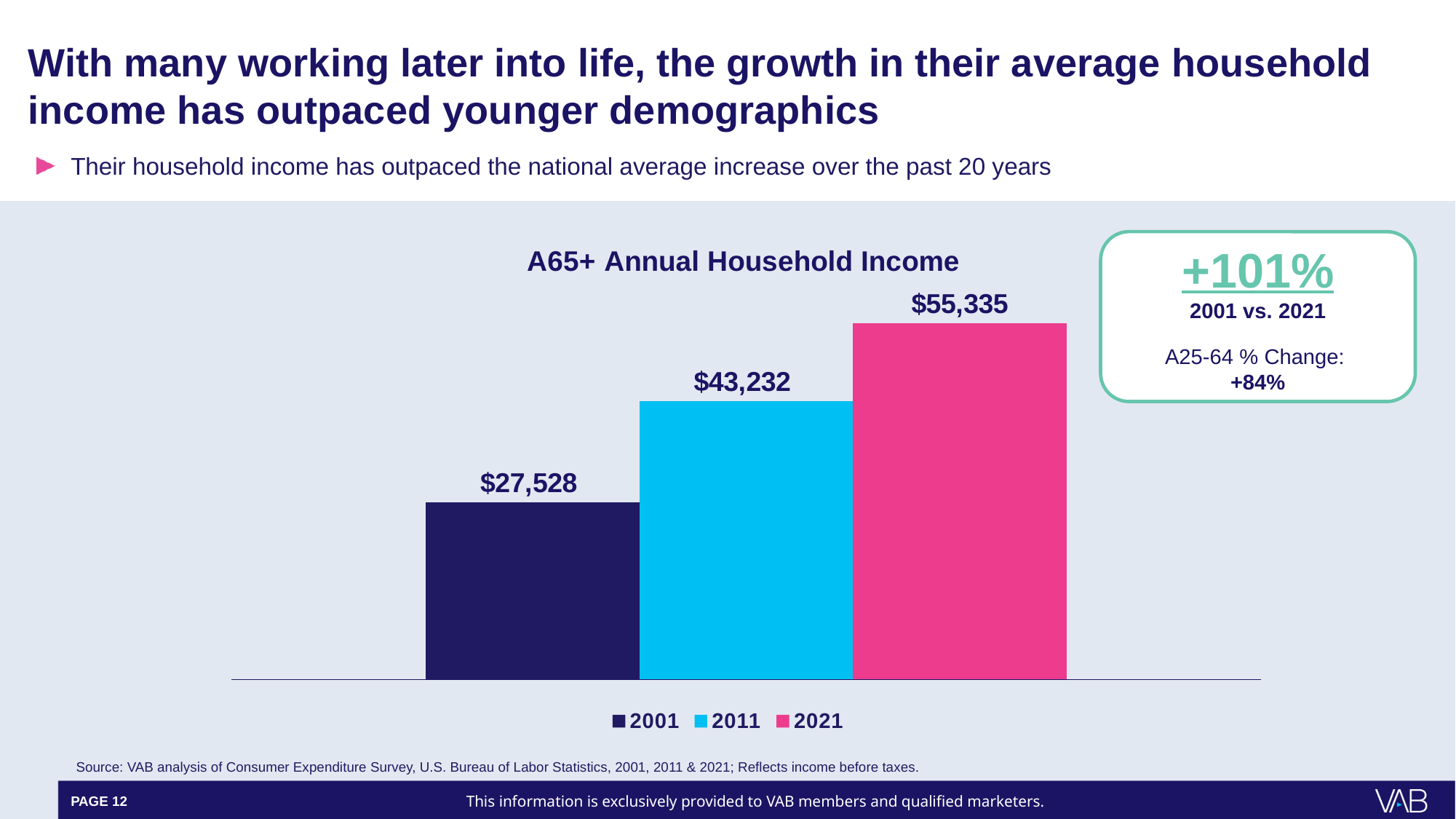
How many bars are plotted in the chart? 3 What is the difference between the 2011 and 2001 A65+ annual household income values? $15,704 What kind of chart is shown on the slide? Bar chart How many entries does the legend list? 3 Which year has the lowest A65+ annual household income? 2001 Which year has the highest A65+ annual household income? 2021 Which is larger, the A65+ household income in 2011 or in 2021? 2021 Do the A65+ annual household income values rise or fall from 2001 to 2021? Rise What is the A65+ annual household income for 2001? $27,528 What is the difference between the 2021 and 2001 A65+ annual household income values? $27,807 What is the A65+ annual household income for 2011? $43,232 What is the A65+ annual household income for 2021? $55,335